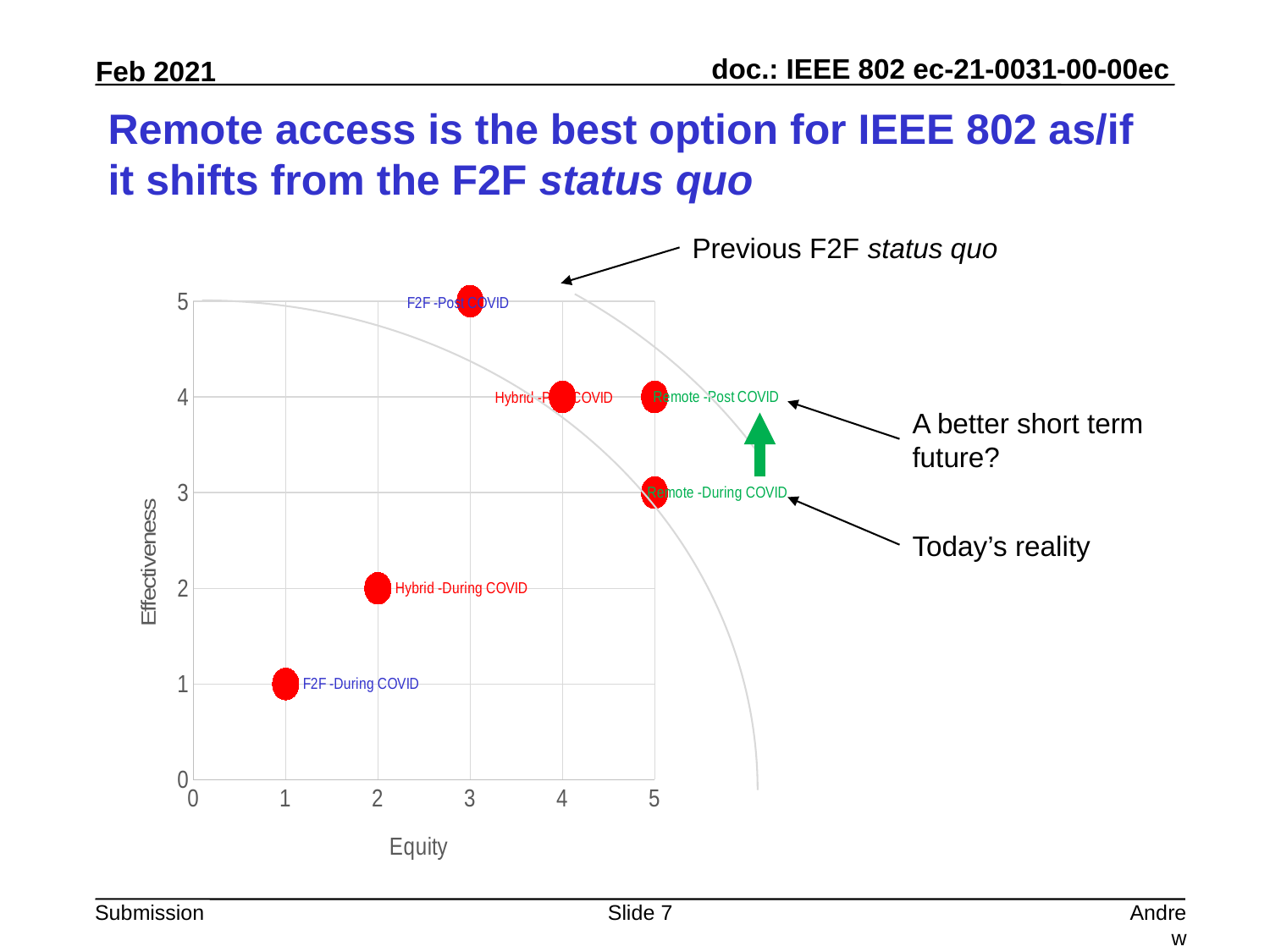
What is the Effectiveness value for F2F - Post COVID? 5 How many data points are plotted on the chart? 6 What is the label of the vertical axis? Effectiveness What is the Effectiveness value for Hybrid - During COVID? 2 What is the Equity value for F2F - During COVID? 1 Which has a higher Equity value, Hybrid - Post COVID or Remote - Post COVID? Remote - Post COVID Which point has the highest Effectiveness value? F2F - Post COVID What is the Equity value for Remote - During COVID? 5 What kind of chart is shown on the slide? Scatter chart What is the difference in Effectiveness between Remote - Post COVID and Remote - During COVID? 1 Which point has the lowest Equity value? F2F - During COVID What is the label of the horizontal axis? Equity